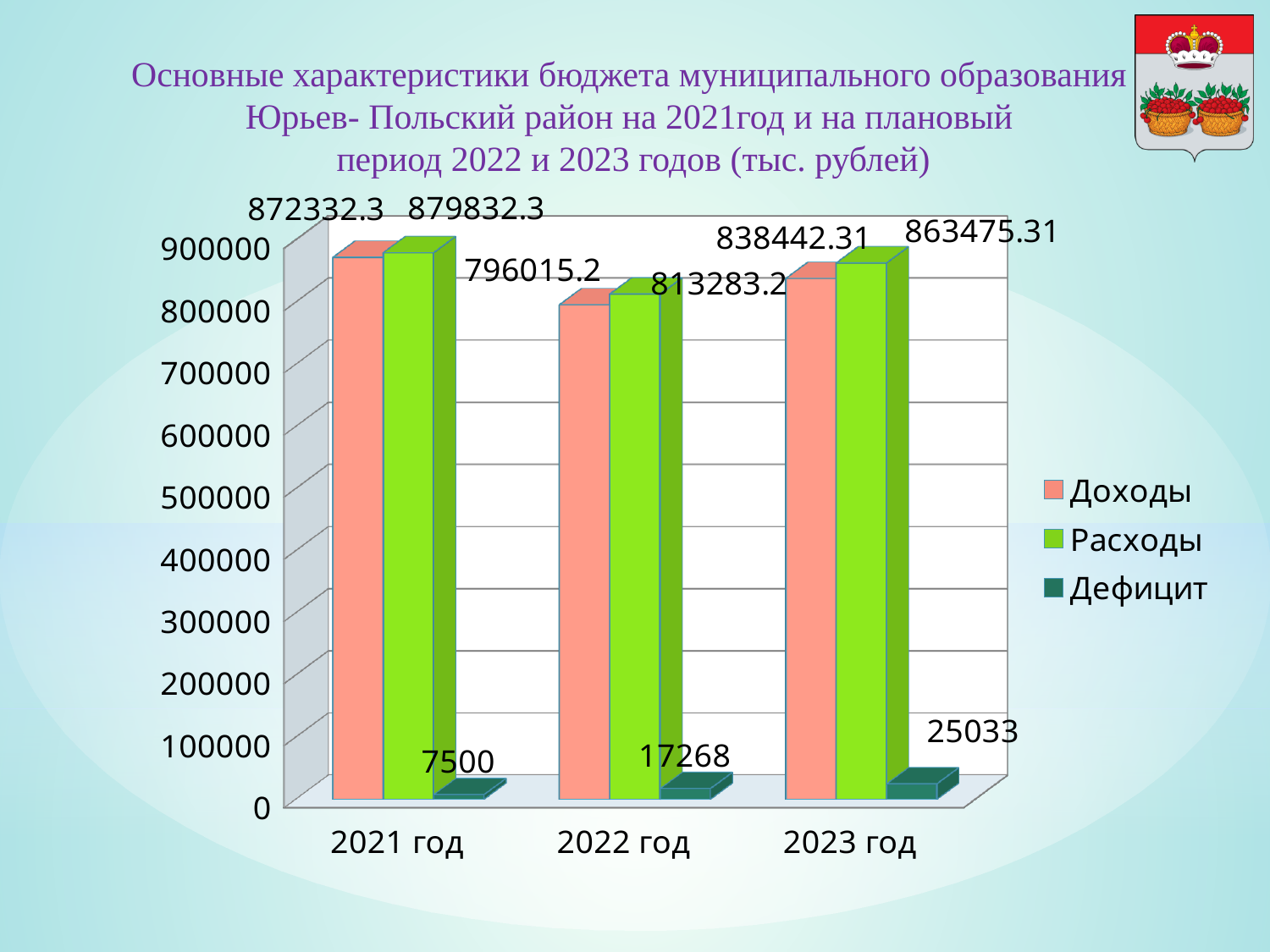
What is the value of Доходы for 2021 год? 872332.3 In which year is Дефицит the highest? 2023 год What is the value of Расходы for 2023 год? 863475.31 In which year is Доходы the lowest? 2022 год What kind of chart is shown on the slide? bar chart What is the value of Расходы for 2022 год? 813283.2 What is the value of Дефицит for 2023 год? 25033 How many series does the legend list? 3 Is the value of Доходы for 2022 год greater or less than 800000? less Which is larger for 2023 год, Доходы or Расходы? Расходы What is the difference between Расходы and Доходы for 2022 год? 17268 How many years are shown on the x axis? 3